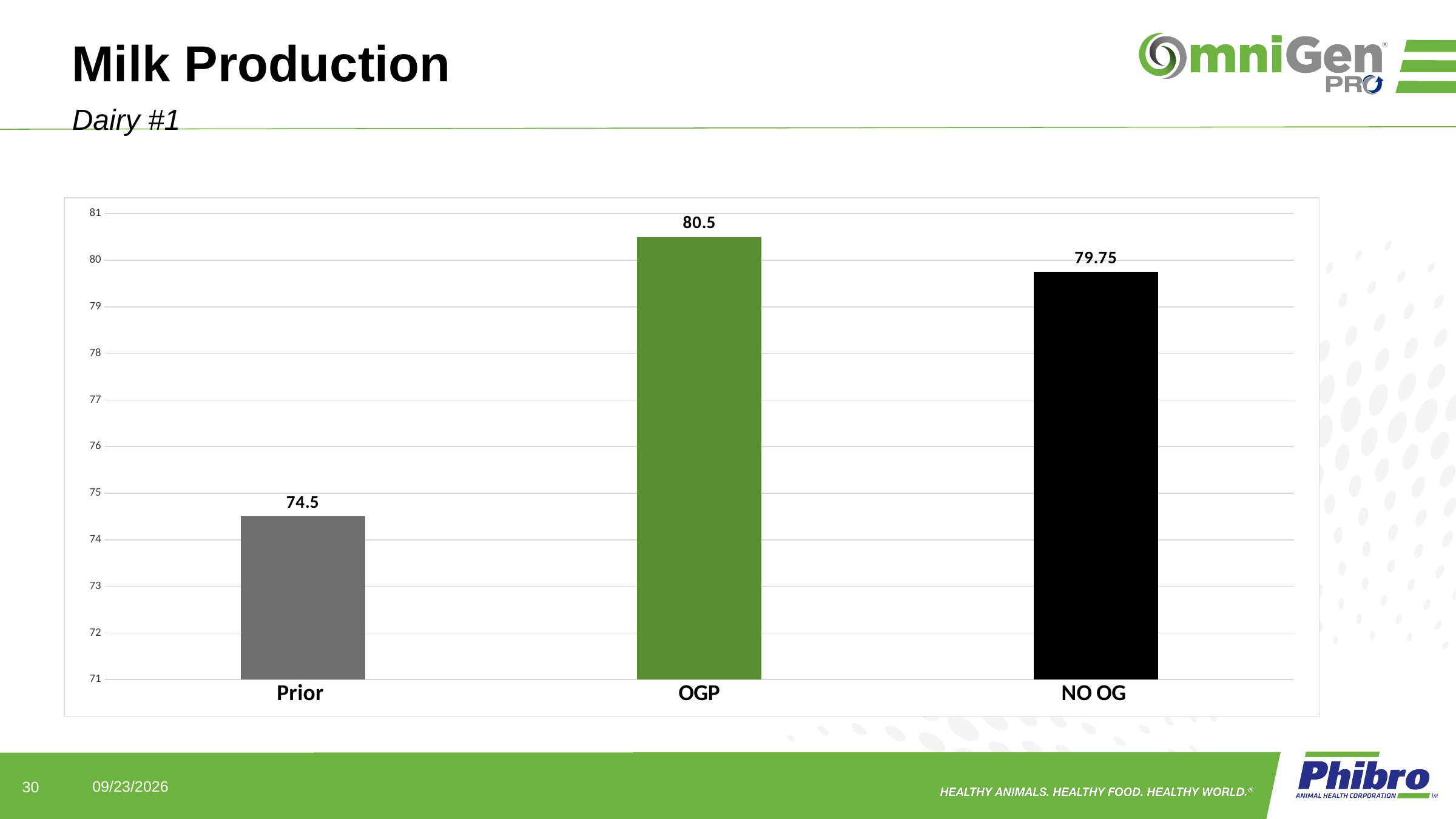
What is the value for OGP? 80.5 What is the difference between the OGP and NO OG values? 0.75 What is the value for Prior? 74.5 What is the difference between the OGP and Prior values? 6 Is the value for Prior greater or less than 75? less Which category has the highest value? OGP What is the value for NO OG? 79.75 Which is larger, the value for NO OG or the value for Prior? NO OG How many categories are shown on the x axis? 3 What kind of chart is shown on the slide? bar chart What colour is the OGP bar? green Which category has the lowest value? Prior